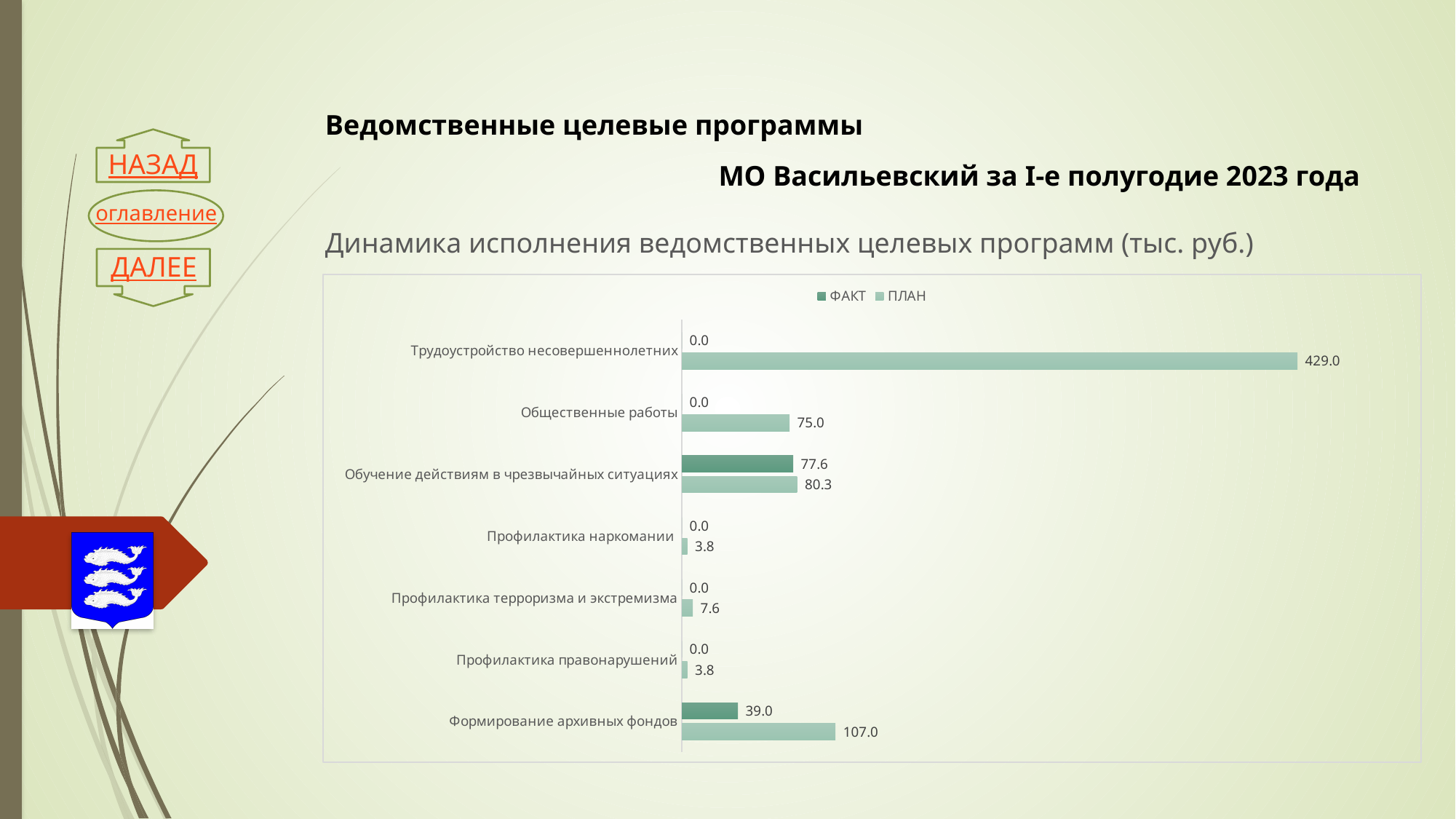
Which category has the highest ПЛАН value? Трудоустройство несовершеннолетних Which is larger: the ПЛАН value for Общественные работы or the ПЛАН value for Профилактика терроризма и экстремизма? Общественные работы What is the ПЛАН value for Трудоустройство несовершеннолетних? 429.0 Which category has the highest ФАКТ value? Обучение действиям в чрезвычайных ситуациях What is the ФАКТ value for Формирование архивных фондов? 39.0 How many series does the legend list? 2 What is the ФАКТ value for Обучение действиям в чрезвычайных ситуациях? 77.6 What is the difference between the ПЛАН and ФАКТ values for Обучение действиям в чрезвычайных ситуациях? 2.7 How many categories are shown on the chart? 7 What is the ПЛАН value for Формирование архивных фондов? 107.0 What kind of chart is shown on the slide? Bar chart What is the difference between the ПЛАН and ФАКТ values for Формирование архивных фондов? 68.0